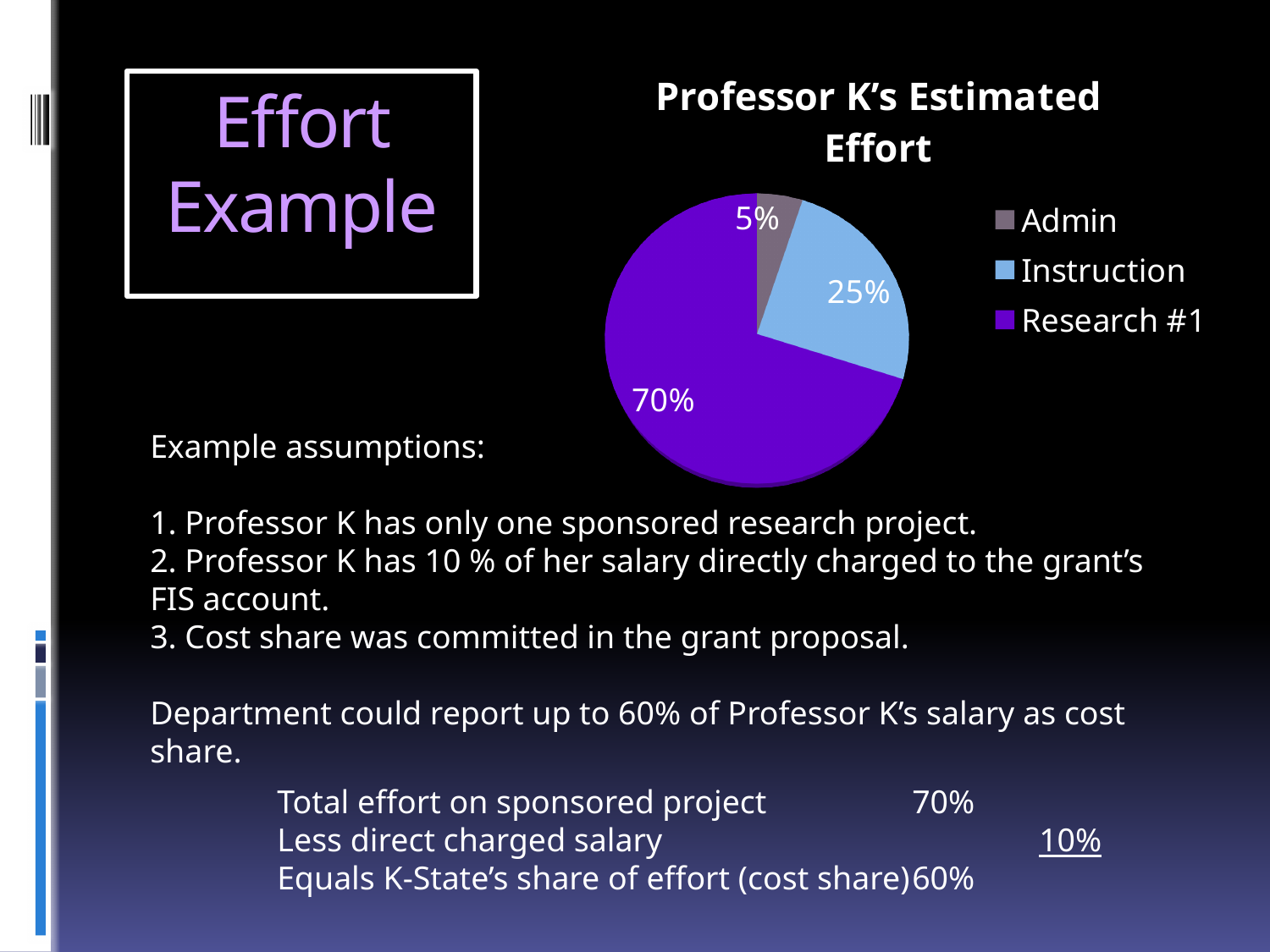
How many categories does the legend list? 3 What colour is the Instruction slice? light blue What is the difference between the Research #1 and Instruction shares? 45% What type of chart is shown on the slide? pie chart What is the title of the chart? Professor K's Estimated Effort What is the combined share of Instruction and Admin? 30% What percentage of effort is shown for Admin? 5% Which category has the largest share of the pie? Research #1 Which category has the smallest share of the pie? Admin Which is larger, the Instruction share or the Admin share? Instruction What percentage of effort is shown for Instruction? 25% What percentage of effort is shown for Research #1? 70%